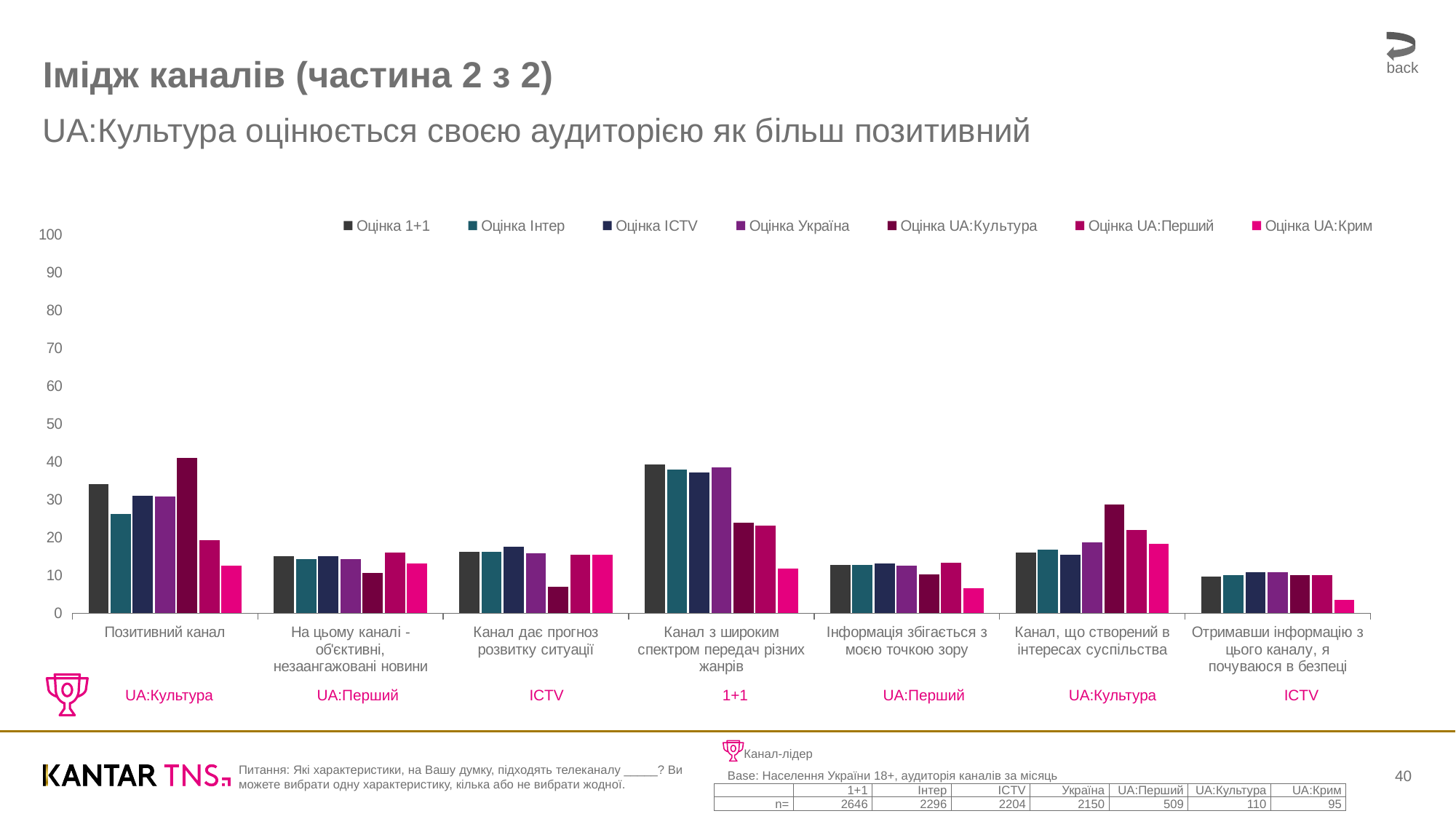
For the category "Позитивний канал", which series has the lowest bar? Оцінка UA:Крим Is the value for Оцінка UA:Культура in the category "Канал дає прогноз розвитку ситуації" greater or less than 10? less For the category "Канал з широким спектром передач різних жанрів", which series has the lowest bar? Оцінка UA:Крим How many categories are shown along the x axis? 7 For the category "Канал, що створений в інтересах суспільства", which series has the highest bar? Оцінка UA:Культура What kind of chart is shown on the slide? bar chart In the category "Позитивний канал", which is larger: the value for Оцінка 1+1 or the value for Оцінка Інтер? Оцінка 1+1 For the category "Позитивний канал", which series has the highest bar? Оцінка UA:Культура Is the value for Оцінка UA:Крим in the category "Отримавши інформацію з цього каналу, я почуваюся в безпеці" greater or less than 10? less Is the value for Оцінка UA:Культура in the category "Позитивний канал" greater or less than 30? greater How many series does the legend list? 7 According to the leader row below the chart, which channel is the leader for "Канал дає прогноз розвитку ситуації"? ICTV